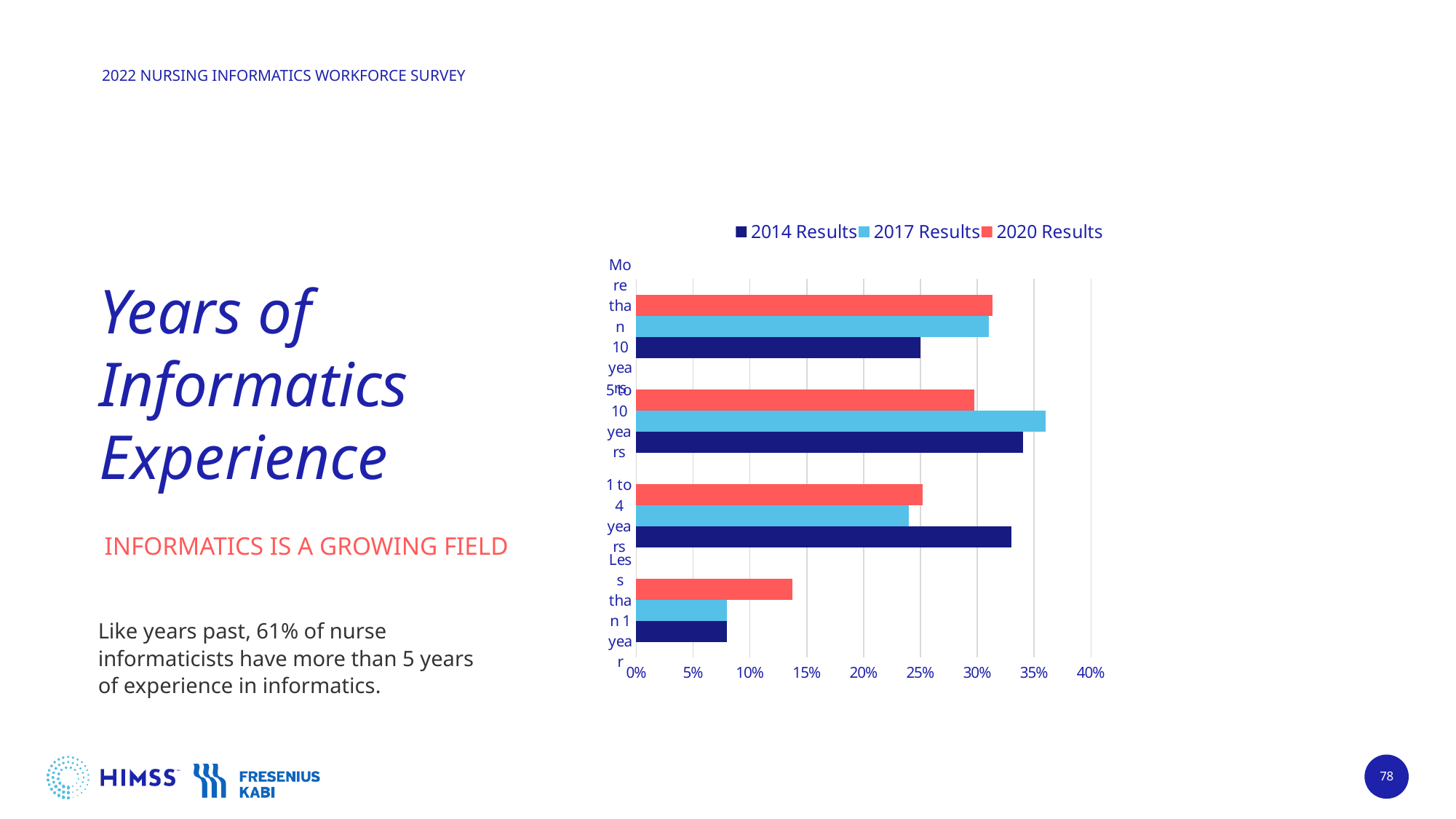
How many experience categories are plotted on the chart? 4 Is the 2020 Results value for Less than 1 year greater or less than 15%? less Which category has the lowest value in the 2020 Results series? Less than 1 year Is the 2017 Results value for Less than 1 year greater or less than 10%? less How many series does the chart legend list? 3 For the Less than 1 year category, which is larger: the 2020 Results value or the 2014 Results value? 2020 Results What kind of chart is shown on the slide? Bar chart Is the 2017 Results value for 5 to 10 years greater or less than 35%? greater For the 1 to 4 years category, which is larger: the 2014 Results value or the 2017 Results value? 2014 Results Which series is shown in red on the chart? 2020 Results Which category has the highest value in the 2017 Results series? 5 to 10 years